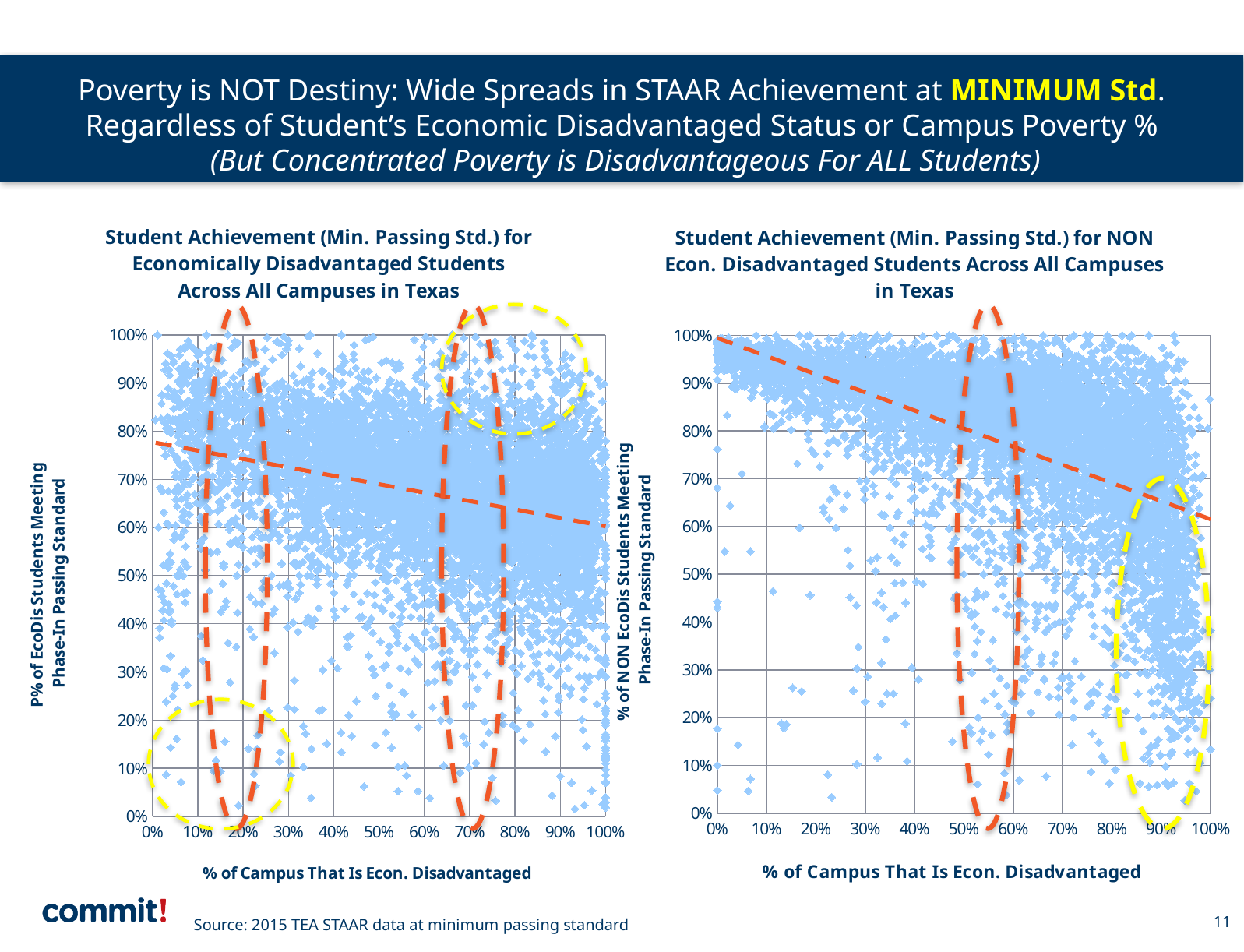
In the left chart (Economically Disadvantaged Students), does the dashed trend line rise or fall as the % of campus that is economically disadvantaged increases? fall In the right chart (NON Econ. Disadvantaged Students), does the dashed trend line rise or fall as the % of campus that is economically disadvantaged increases? fall What kind of chart is the right chart, titled 'Student Achievement (Min. Passing Std.) for NON Econ. Disadvantaged Students Across All Campuses in Texas'? scatter chart What is the y-axis title of the right chart (NON Econ. Disadvantaged Students)? % of NON EcoDis Students Meeting Phase-In Passing Standard What is the x-axis title of the left chart (Economically Disadvantaged Students)? % of Campus That Is Econ. Disadvantaged How many charts are shown on the slide? 2 What kind of chart is the left chart, titled 'Student Achievement (Min. Passing Std.) for Economically Disadvantaged Students Across All Campuses in Texas'? scatter chart